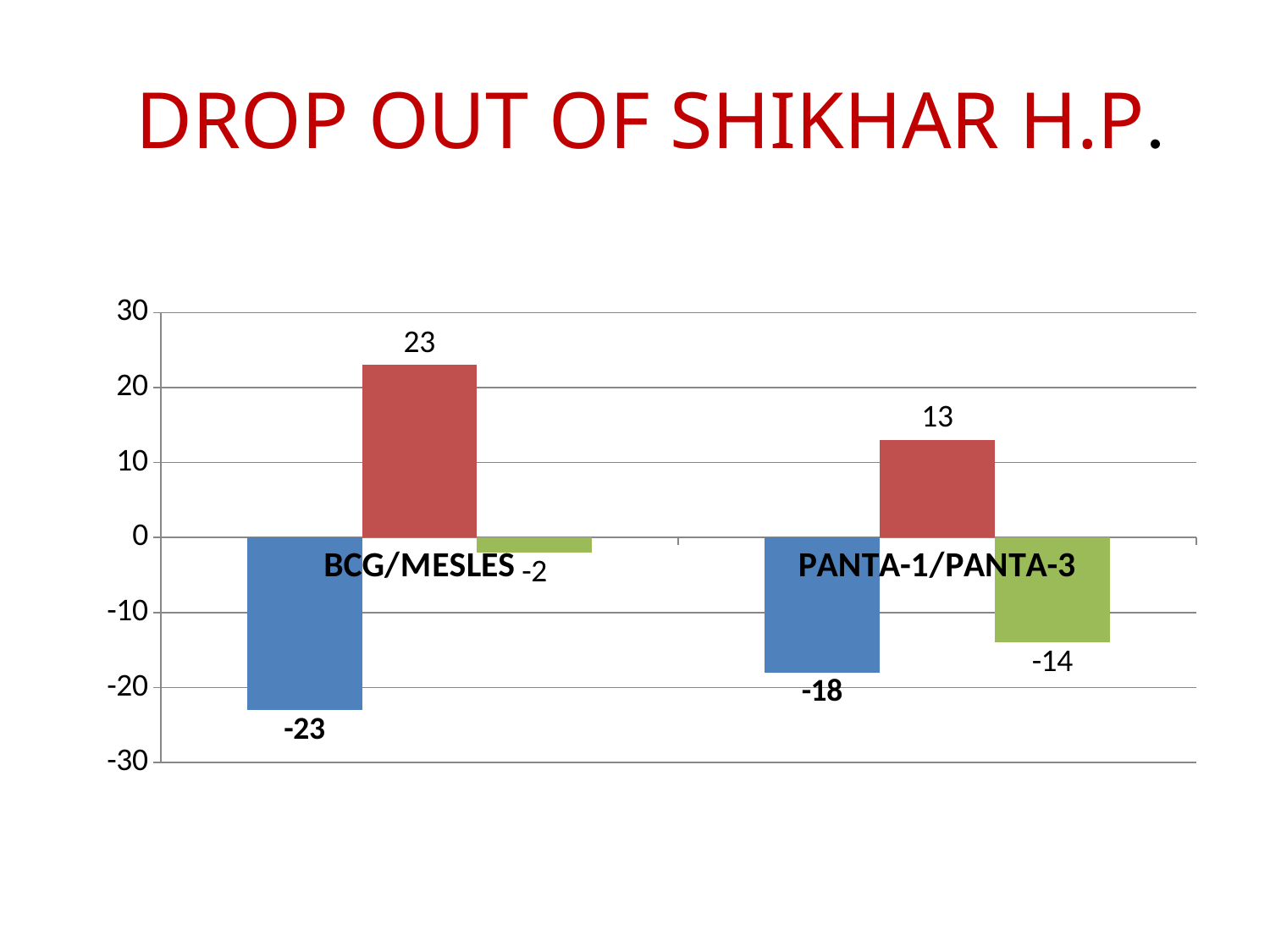
What is the value of the green bar for PANTA-1/PANTA-3? -14 What is the value of the red bar for PANTA-1/PANTA-3? 13 What is the value of the red bar for BCG/MESLES? 23 Which bar has the lowest value on the chart? The blue bar for BCG/MESLES (-23) What is the value of the green bar for BCG/MESLES? -2 What is the value of the blue bar for PANTA-1/PANTA-3? -18 What is the value of the blue bar for BCG/MESLES? -23 How many categories are shown on the x axis? 2 Which bar has the highest value on the chart? The red bar for BCG/MESLES (23) What is the difference between the red bar values for BCG/MESLES and PANTA-1/PANTA-3? 10 Which is larger, the green bar value for BCG/MESLES or the green bar value for PANTA-1/PANTA-3? BCG/MESLES (-2) What type of chart is shown on the slide? Bar chart